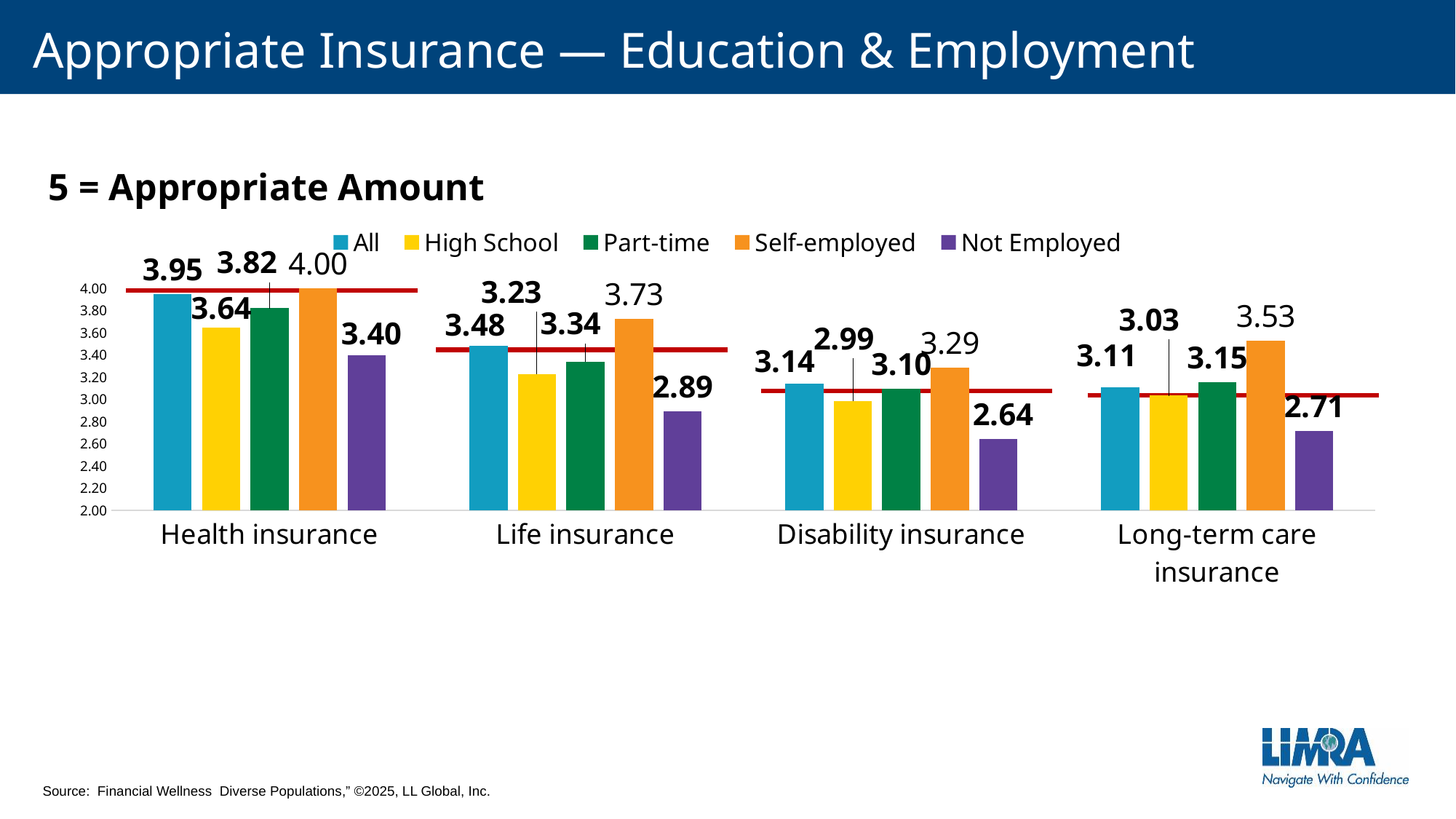
Which series has the highest value for Long-term care insurance? Self-employed Is the Not Employed value for Health insurance greater or less than 3.20? greater Which series has the lowest value for Disability insurance? Not Employed What kind of chart is shown on the slide? Bar chart What is the value for Not Employed for Life insurance? 2.89 What is the difference between the All value for Health insurance and the All value for Life insurance? 0.47 What is the value for Self-employed for Health insurance? 4.00 How many series does the legend list? 5 How many insurance categories are shown on the x axis? 4 What is the value for Part-time for Long-term care insurance? 3.15 Which is larger for Life insurance: the High School value or the Part-time value? Part-time What is the value for High School for Disability insurance? 2.99